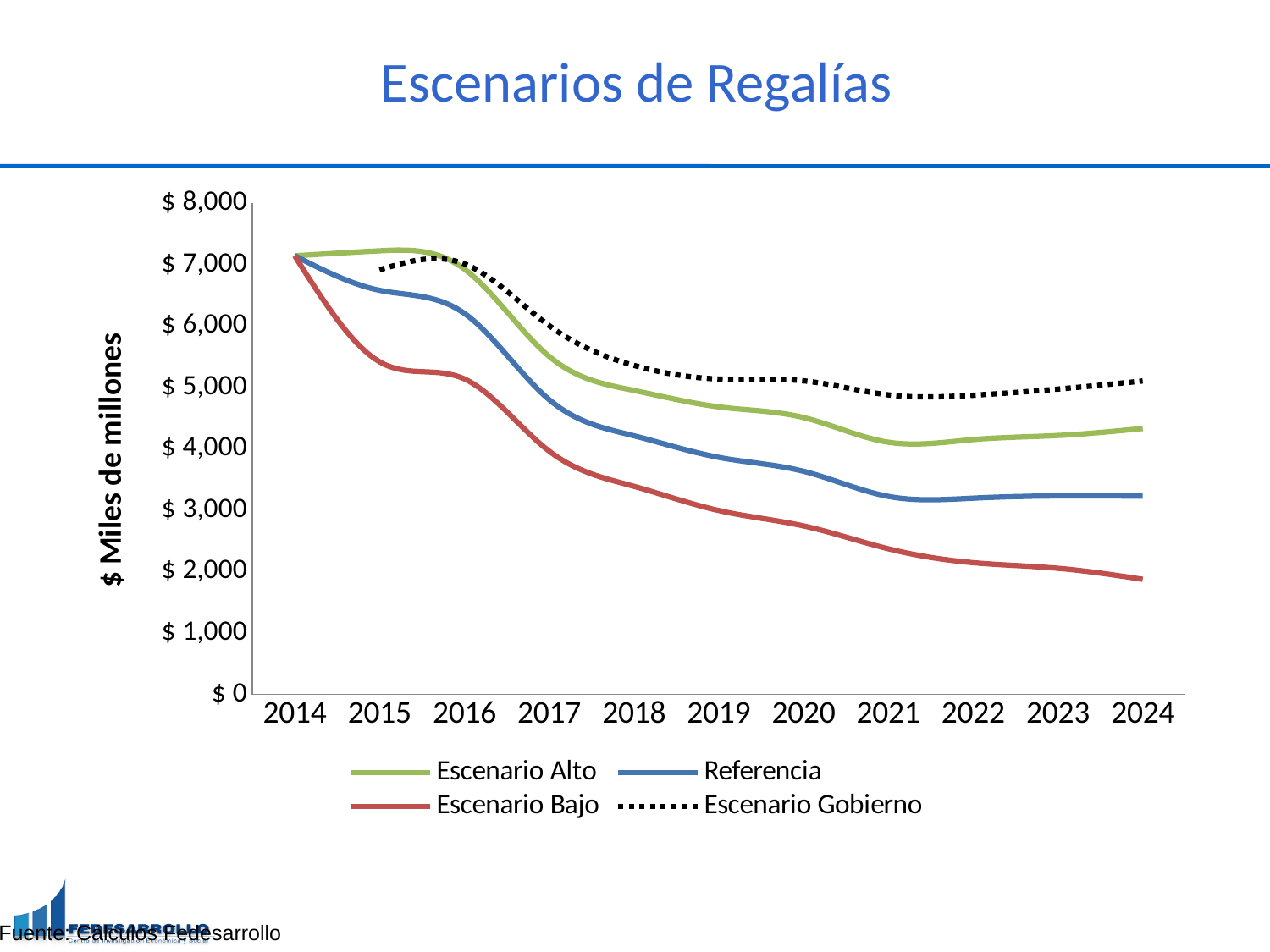
Which series has the lowest value in 2024? Escenario Bajo Is the value for Escenario Alto in 2024 greater or less than $ 4,000? greater In 2018, which is larger: Escenario Gobierno or Escenario Bajo? Escenario Gobierno In 2020, which is larger: Escenario Alto or Referencia? Escenario Alto Which series has the highest value in 2024? Escenario Gobierno What kind of chart is shown on the slide? line chart Does the Escenario Bajo line rise or fall from 2014 to 2024? fall How many years are shown on the x axis? 11 Is the value for Escenario Bajo in 2024 greater or less than $ 3,000? less How many series does the legend list? 4 Is the value for Referencia in 2024 greater or less than $ 4,000? less